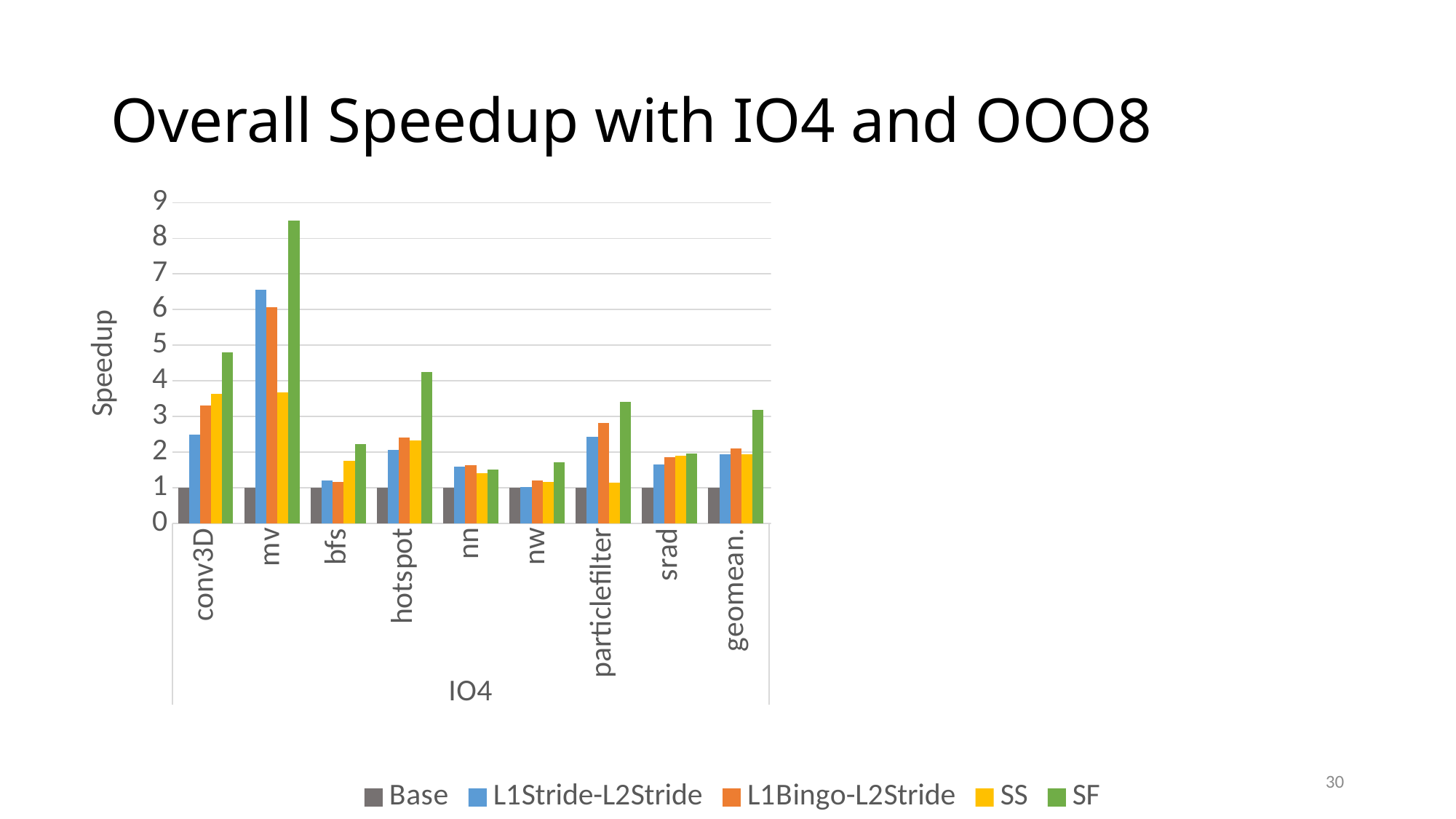
Is the L1Stride-L2Stride value for mv greater or less than 6? greater Which series has the highest value for mv? SF Which category has the highest SF speedup? mv What is the Base speedup value for conv3D? 1 Is the SF value for mv greater or less than 8? greater Is the SF value for particlefilter greater or less than 3? greater How many series does the chart's legend list? 5 What kind of chart is shown on the slide? bar chart For conv3D, which is larger: the SF value or the L1Stride-L2Stride value? SF What is the title of the chart's vertical axis? Speedup How many categories are shown along the x axis of the chart? 9